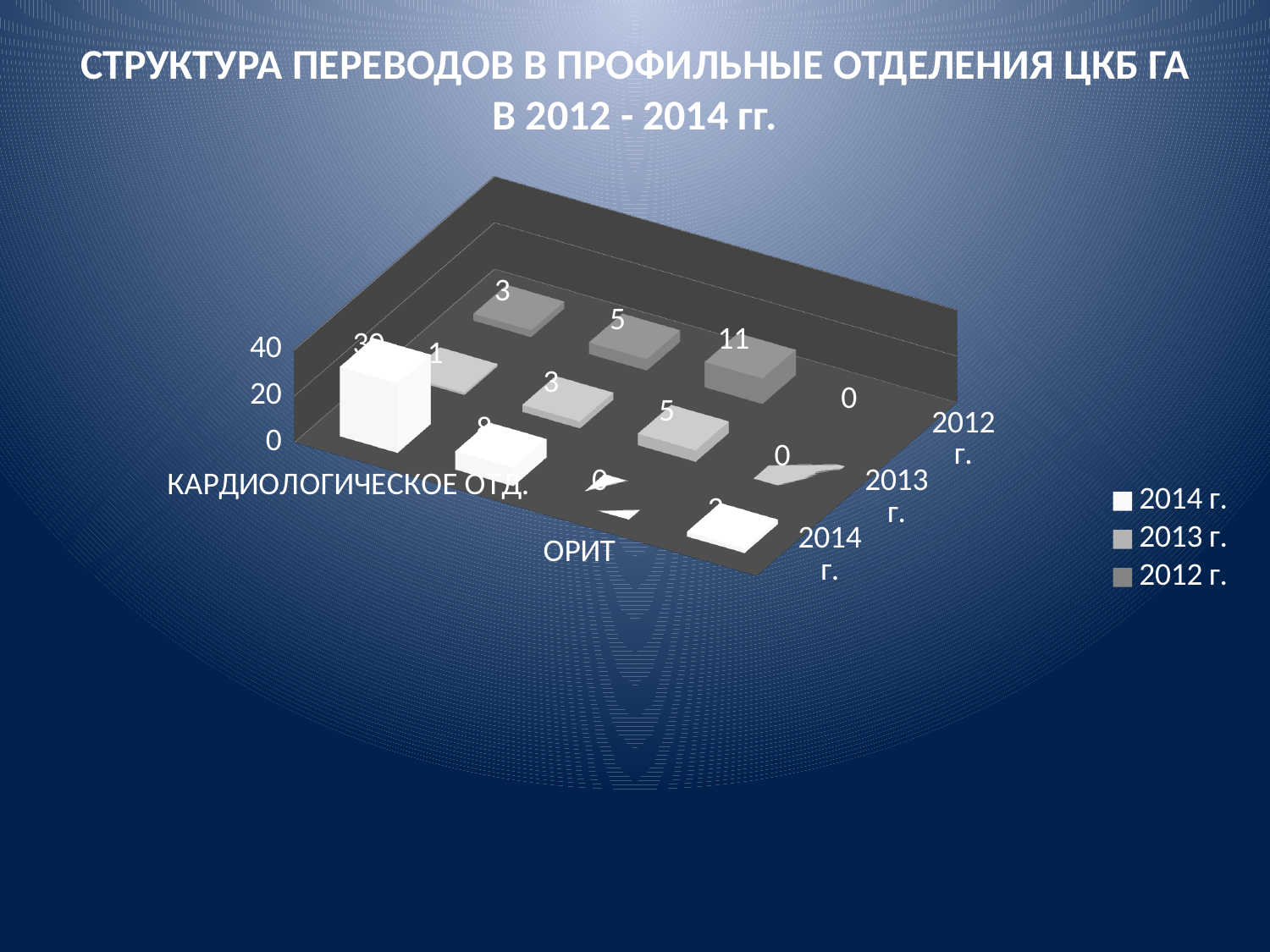
How many series does the legend list? 3 What is the value for ОРИТ in the 2012 г. series? 11 Is the value for КАРДИОЛОГИЧЕСКОЕ ОТД. in the 2014 г. series greater or less than 20? greater Which is larger for ОРИТ: the 2012 г. value or the 2013 г. value? 2012 г. Do the values for ОРИТ rise or fall from 2012 г. to 2014 г.? fall What is the value for ОРИТ in the 2013 г. series? 5 What is the value for КАРДИОЛОГИЧЕСКОЕ ОТД. in the 2012 г. series? 3 Which year has the highest value for ОРИТ? 2012 г. What is the difference between the 2012 г. and 2013 г. values for ОРИТ? 6 What is the value for ОРИТ in the 2014 г. series? 0 What is the value for КАРДИОЛОГИЧЕСКОЕ ОТД. in the 2013 г. series? 1 What kind of chart is shown on the slide? bar chart